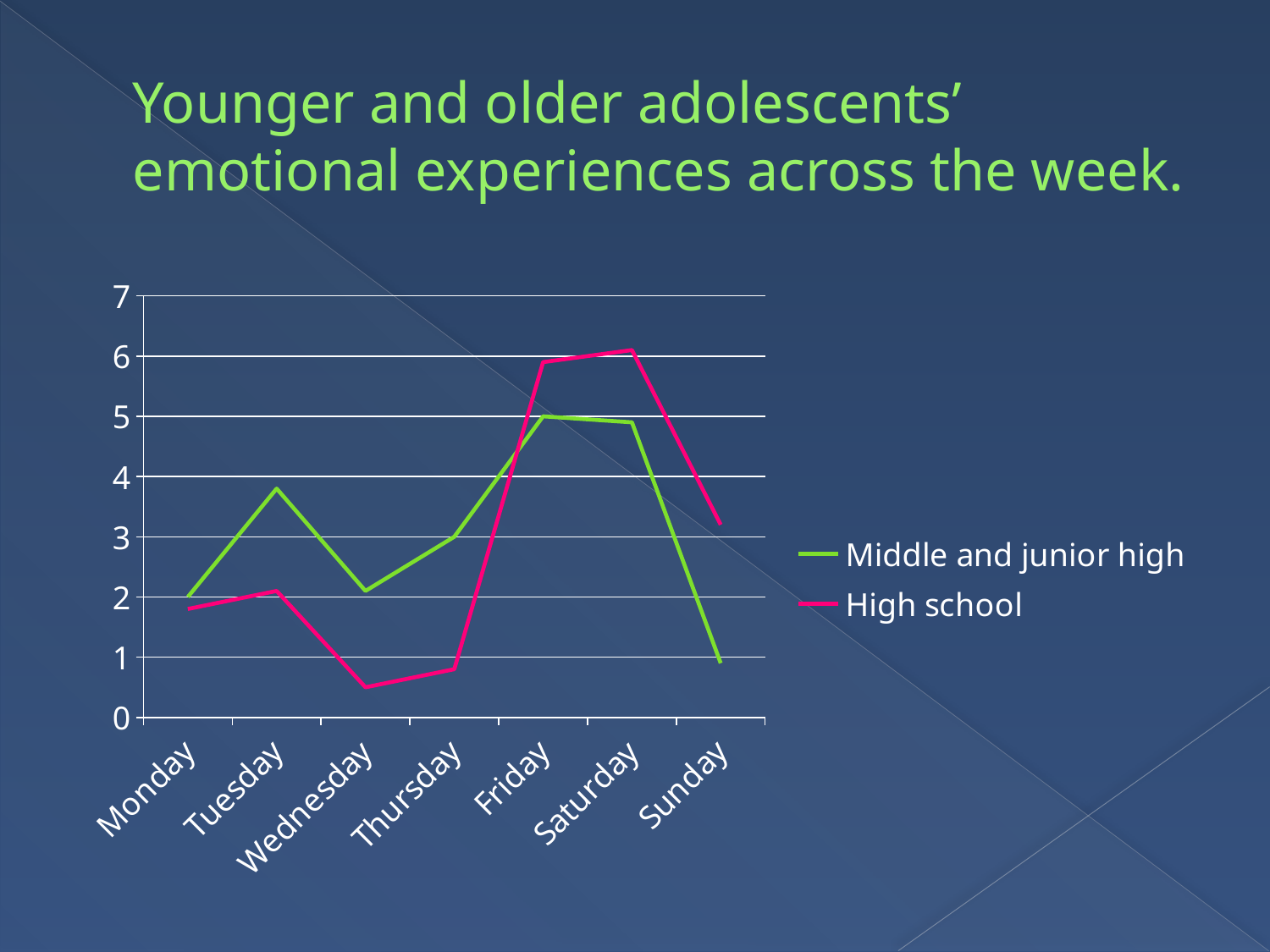
Is the value for High school on Wednesday greater or less than 1? less How many days are plotted along the x axis? 7 On Tuesday, which series has the larger value, Middle and junior high or High school? Middle and junior high Is the value for High school on Sunday greater or less than 3? greater On which day is the Middle and junior high series at its lowest? Sunday What kind of chart is shown on the slide? line chart On which day is the High school series at its highest? Saturday Is the value for Middle and junior high on Tuesday greater or less than 3? greater Does the High school series rise or fall from Wednesday to Saturday? rise How many series does the legend list? 2 On Sunday, which series has the larger value, Middle and junior high or High school? High school